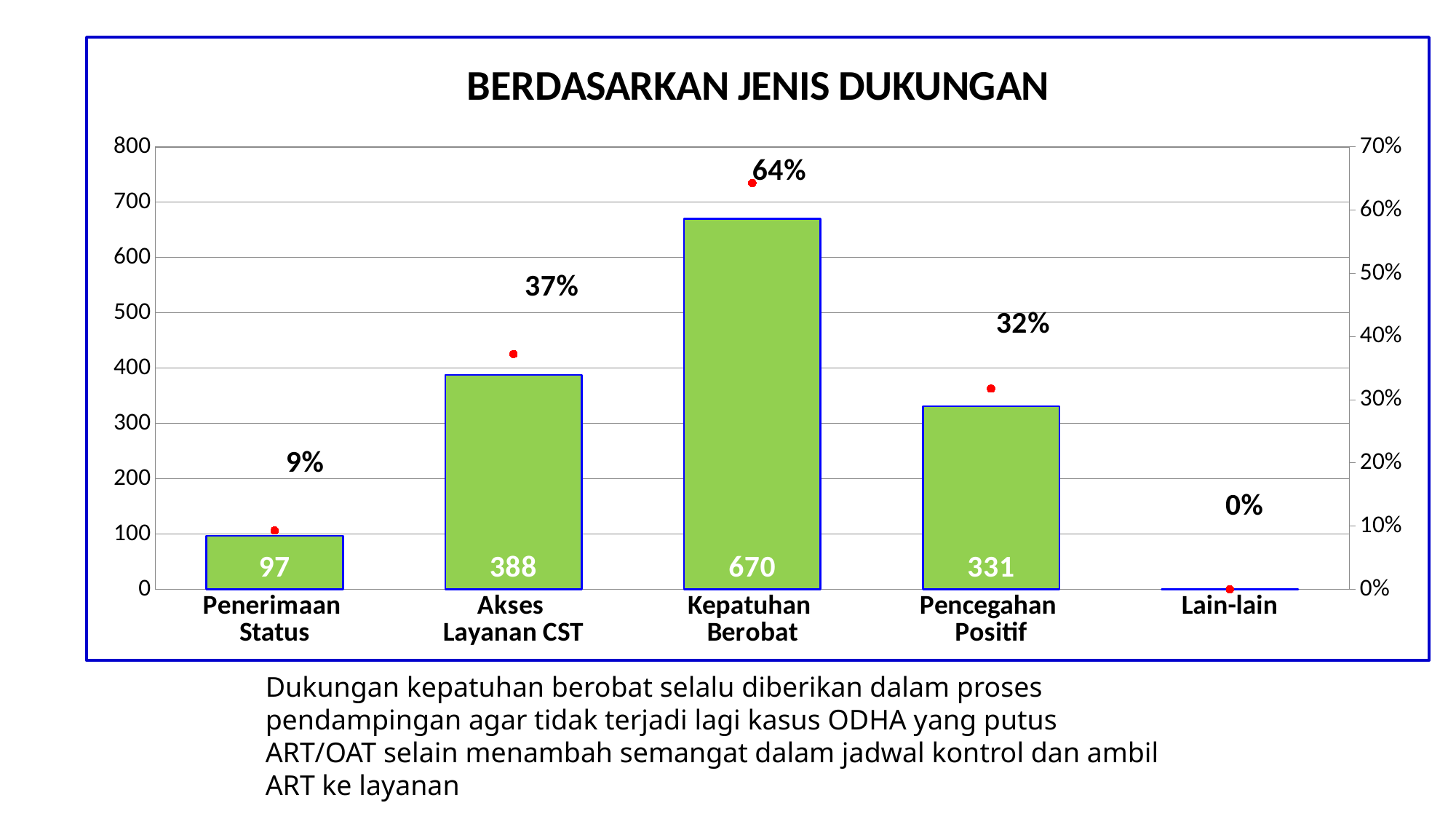
How many categories are shown on the x axis? 5 What percentage is shown for Akses Layanan CST? 37% Which has a larger bar value, Pencegahan Positif or Penerimaan Status? Pencegahan Positif Which category has the highest bar value? Kepatuhan Berobat What kind of chart is this? combination bar and line chart (bars with percentage markers on a secondary axis) What is the value of the bar for Penerimaan Status? 97 What is the value of the bar for Kepatuhan Berobat? 670 Which category has the lowest percentage shown? Lain-lain What percentage is shown for Pencegahan Positif? 32% What is the title of the chart? BERDASARKAN JENIS DUKUNGAN What is the difference between the bar values for Kepatuhan Berobat and Akses Layanan CST? 282 Is the bar value for Akses Layanan CST greater or less than 300? greater